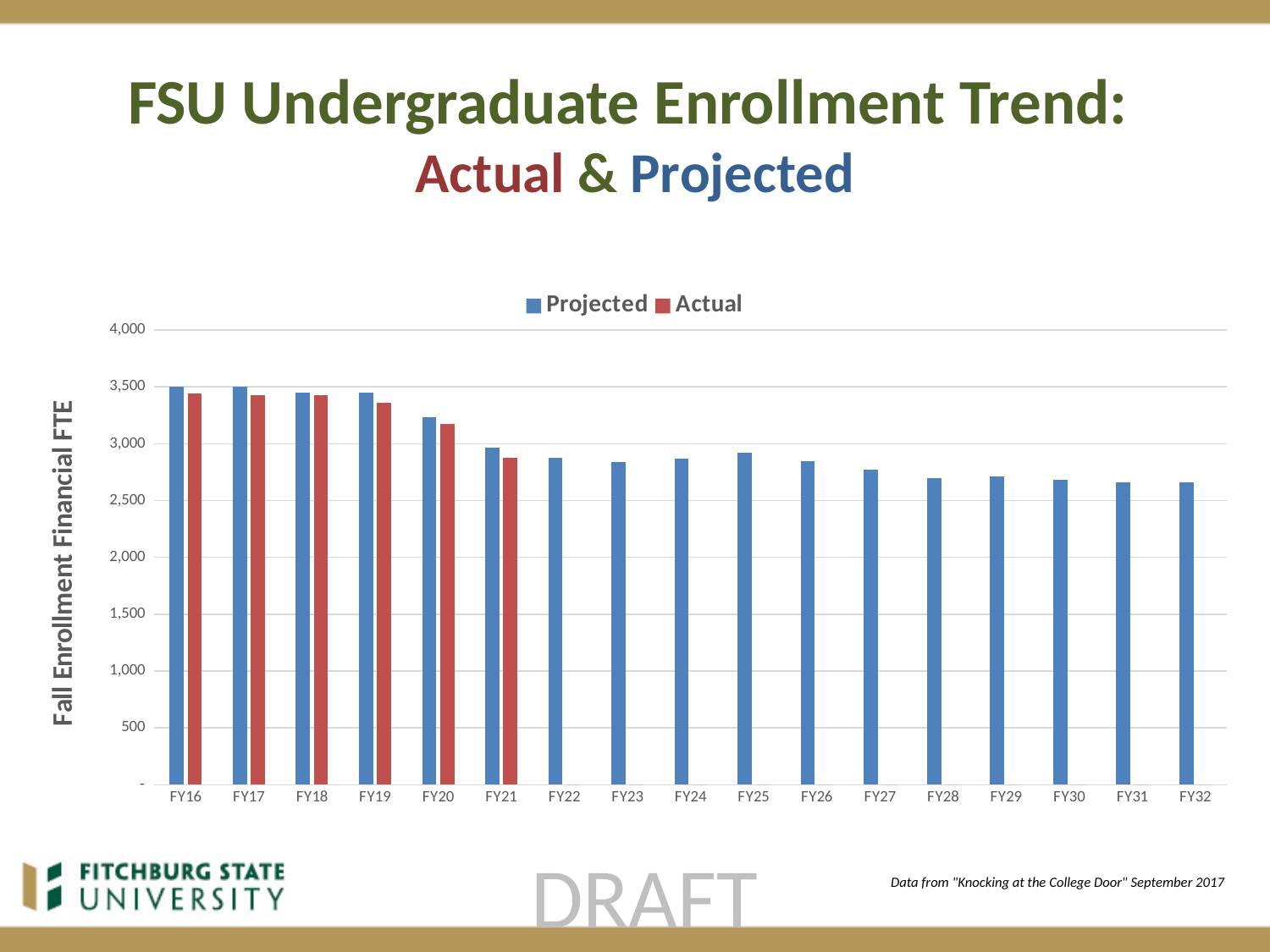
Do the Projected values generally rise or fall from FY16 to FY32? fall What is the title of the vertical axis? Fall Enrollment Financial FTE Is the Actual value for FY19 greater or less than 3,500? less For how many fiscal years is an Actual bar plotted? 6 Is the Projected value for FY32 greater or less than 2,500? greater What kind of chart is shown on the slide? bar chart Is the Projected value for FY20 greater or less than 3,000? greater How many series does the chart legend list? 2 How many fiscal year categories are shown on the x axis? 17 Which fiscal year has the lowest Actual value? FY21 Which is larger, the Projected value for FY16 or the Projected value for FY21? FY16